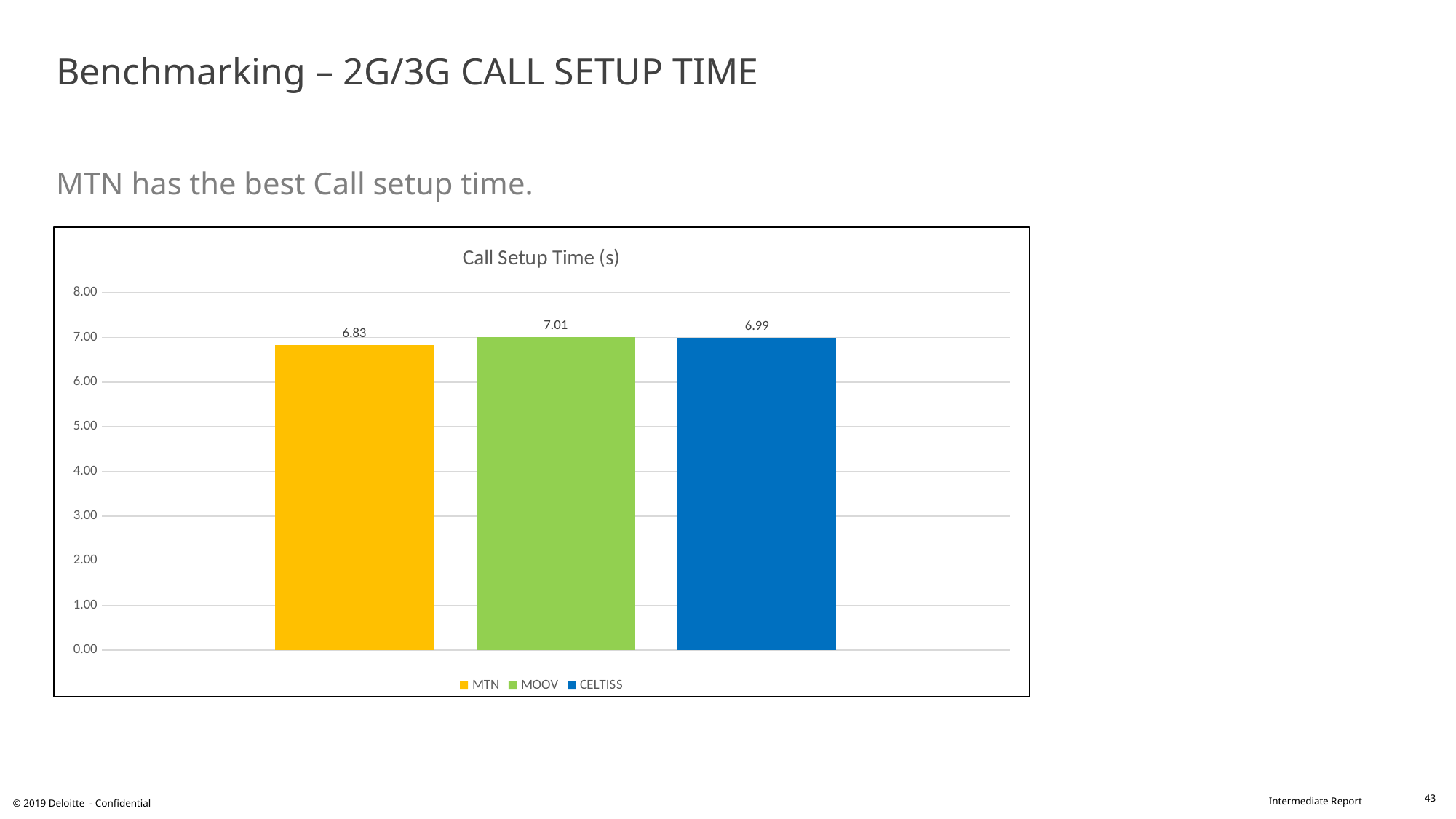
Which operator has the lowest call setup time? MTN Which operator has the highest call setup time? MOOV What is the call setup time for CELTISS? 6.99 What is the difference in call setup time between CELTISS and MTN? 0.16 What is the difference in call setup time between MOOV and MTN? 0.18 Which has a larger call setup time, MOOV or CELTISS? MOOV How many operators are shown in the chart? 3 What is the call setup time for MOOV? 7.01 What is the call setup time for MTN? 6.83 Is the call setup time for MTN greater or less than 7.00? less How many series does the legend list? 3 What type of chart is shown on the slide? bar chart